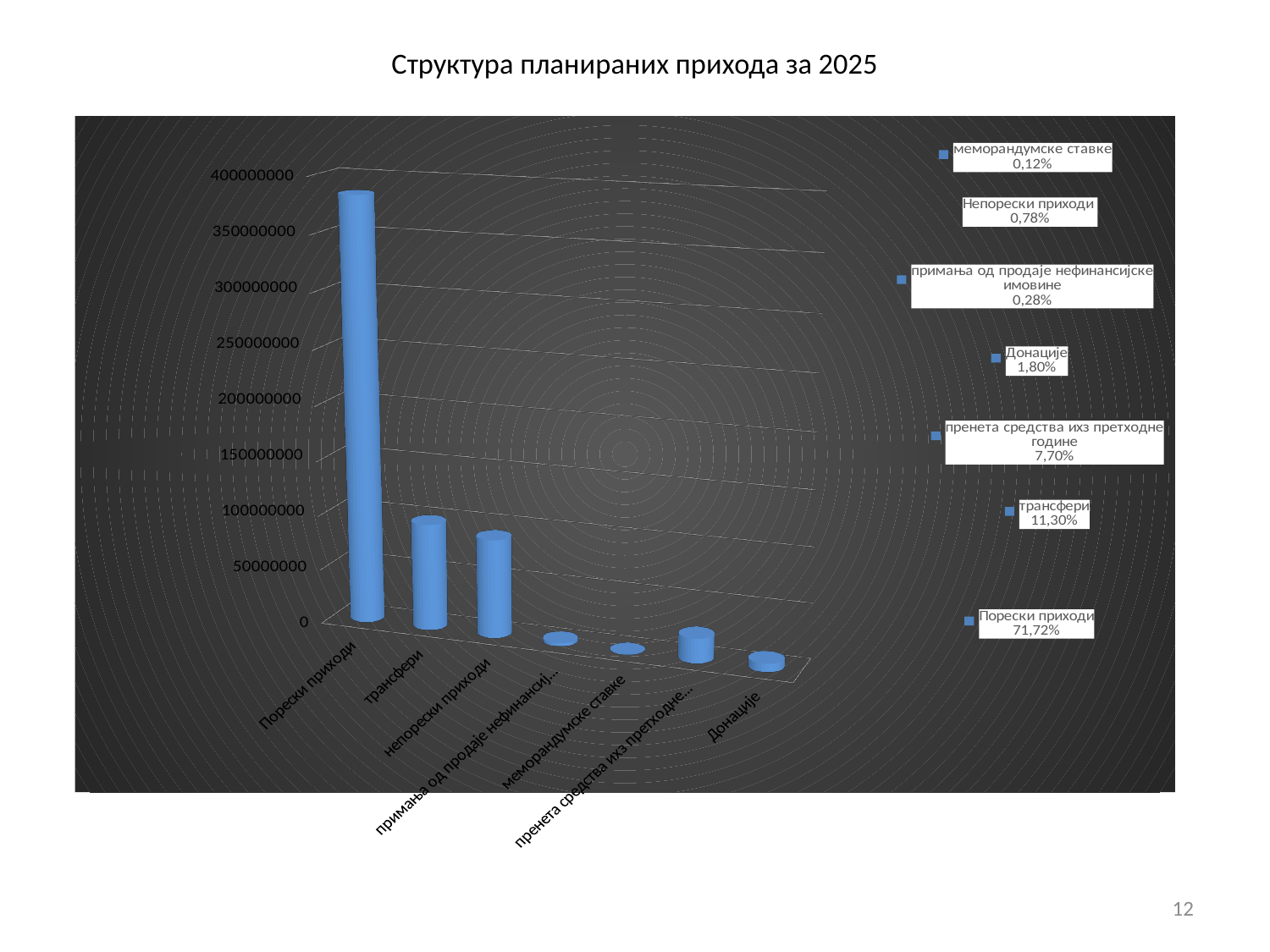
What percentage share is shown for трансфери in the chart labels? 11,30% Which category has the highest bar in the chart? Порески приходи Which is larger, the value for Порески приходи or the value for трансфери? Порески приходи What percentage share is shown for Порески приходи in the chart labels? 71,72% What percentage share is shown for меморандумске ставке? 0,12% What percentage share is shown for Донације? 1,80% How many categories are plotted on the x axis of the chart? 7 Is the value for Порески приходи greater or less than 350000000? greater What is the title of the chart? Структура планираних прихода за 2025 What kind of chart is shown on the slide? bar chart What percentage share is shown for пренета средства ихз претходне године? 7,70%